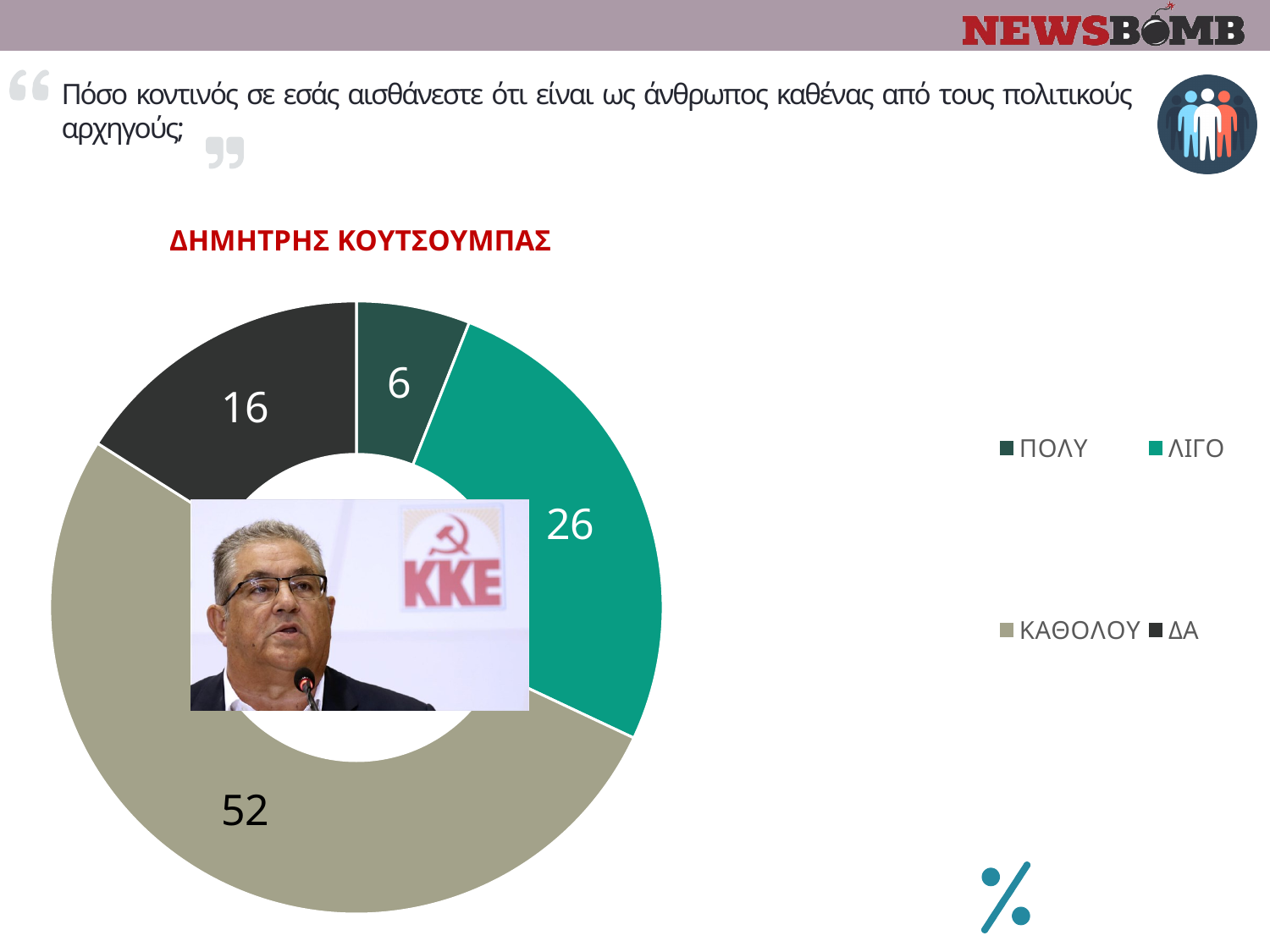
Which category has the largest slice in the chart? ΚΑΘΟΛΟΥ What is the value for ΠΟΛΥ in the chart? 6 What is the combined value of ΠΟΛΥ and ΛΙΓΟ? 32 Which is larger, the value for ΔΑ or the value for ΛΙΓΟ? ΛΙΓΟ What kind of chart is shown on the slide? Doughnut chart What is the title shown above the chart? ΔΗΜΗΤΡΗΣ ΚΟΥΤΣΟΥΜΠΑΣ How many categories does the legend list? 4 What is the difference between the values for ΚΑΘΟΛΟΥ and ΛΙΓΟ? 26 What is the value for ΚΑΘΟΛΟΥ in the chart? 52 What is the value for ΔΑ in the chart? 16 What is the value for ΛΙΓΟ in the chart? 26 Which category has the smallest slice in the chart? ΠΟΛΥ